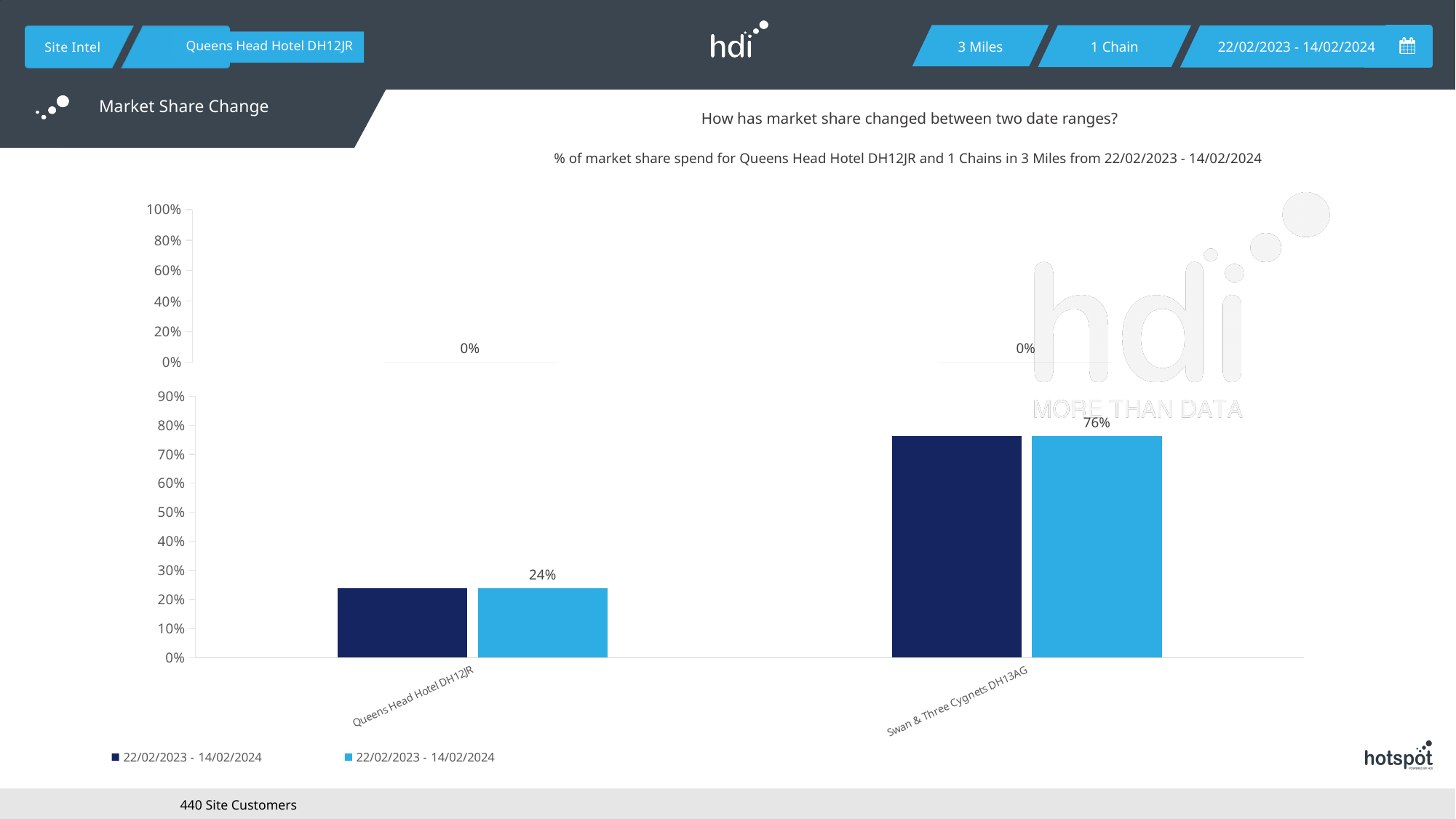
On the bottom chart, is the market share for Swan & Three Cygnets DH13AG greater or less than 70%? greater On the bottom chart, what is the difference between the labelled market share of Swan & Three Cygnets DH13AG and Queens Head Hotel DH12JR? 52% On the bottom chart, what is the labelled market share for Swan & Three Cygnets DH13AG? 76% On the bottom chart, which category has the lowest market share? Queens Head Hotel DH12JR How many categories are shown on the bottom chart's x axis? 2 On the bottom chart, is the market share for Queens Head Hotel DH12JR greater or less than 30%? less On the top chart, what is the labelled value for Swan & Three Cygnets DH13AG? 0% On the bottom chart, what is the labelled market share for Queens Head Hotel DH12JR? 24% What kind of chart is the bottom chart? Bar chart How many series does the legend below the bottom chart list? 2 On the bottom chart, which category has the highest market share? Swan & Three Cygnets DH13AG On the top chart, what is the labelled value for Queens Head Hotel DH12JR? 0%